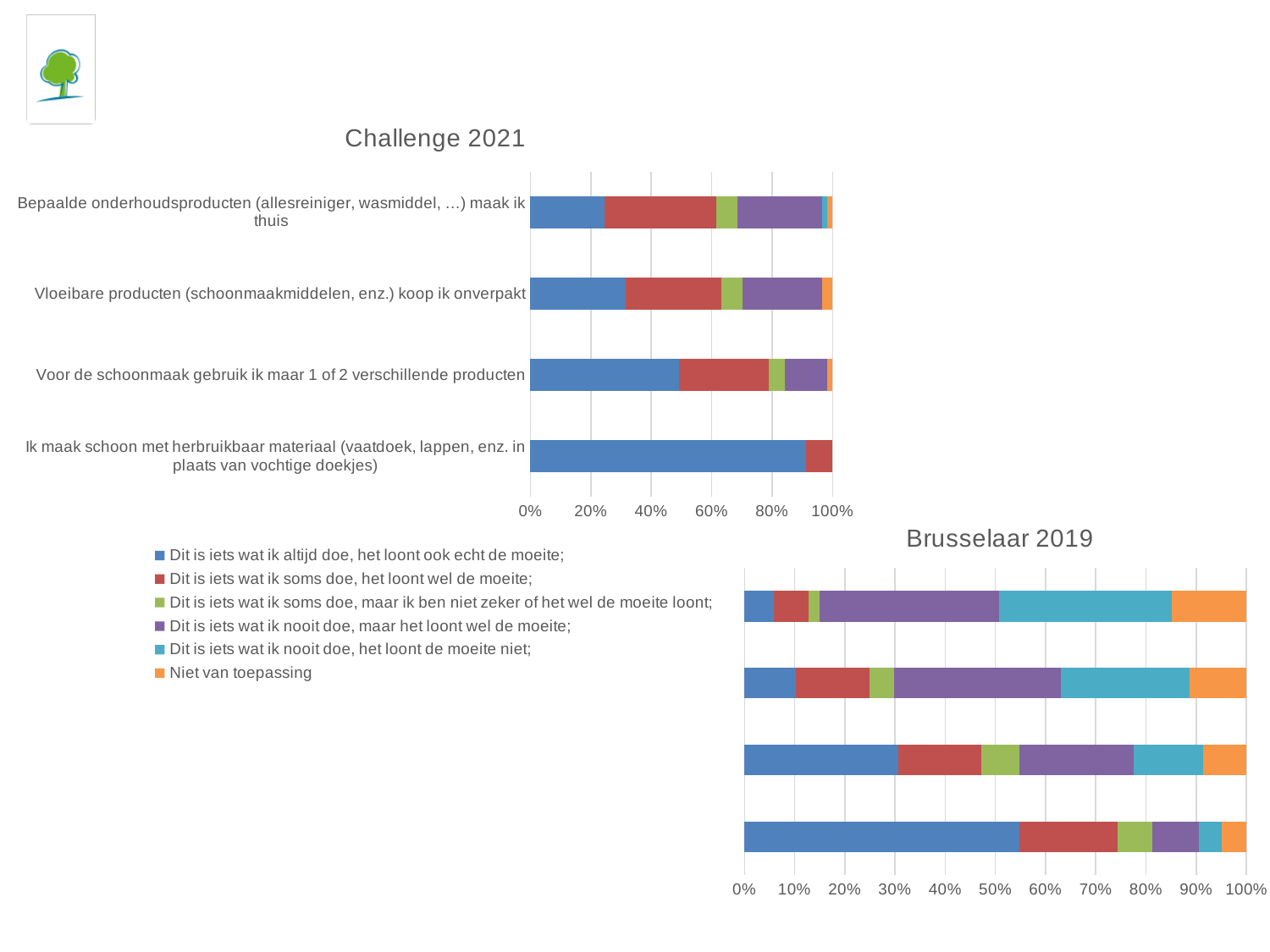
In the Challenge 2021 chart, which category has the largest 'Dit is iets wat ik altijd doe, het loont ook echt de moeite;' segment? Ik maak schoon met herbruikbaar materiaal (vaatdoek, lappen, enz. in plaats van vochtige doekjes) How many series does the legend list? 6 In the Brusselaar 2019 chart, is the 'Dit is iets wat ik altijd doe, het loont ook echt de moeite;' value for the bottom bar greater or less than 50%? greater How many bars are shown in the Brusselaar 2019 chart? 4 In the Challenge 2021 chart, is the 'Dit is iets wat ik altijd doe, het loont ook echt de moeite;' value for 'Ik maak schoon met herbruikbaar materiaal (vaatdoek, lappen, enz. in plaats van vochtige doekjes)' greater or less than 80%? greater How many categories are shown in the Challenge 2021 chart? 4 In the Challenge 2021 chart, which has the larger 'Dit is iets wat ik altijd doe, het loont ook echt de moeite;' segment: 'Voor de schoonmaak gebruik ik maar 1 of 2 verschillende producten' or 'Vloeibare producten (schoonmaakmiddelen, enz.) koop ik onverpakt'? Voor de schoonmaak gebruik ik maar 1 of 2 verschillende producten What type of chart is the Challenge 2021 chart? Stacked bar chart In the Challenge 2021 chart, is the 'Dit is iets wat ik altijd doe, het loont ook echt de moeite;' value for 'Voor de schoonmaak gebruik ik maar 1 of 2 verschillende producten' greater or less than 60%? less What colour represents 'Niet van toepassing' in the legend? Orange